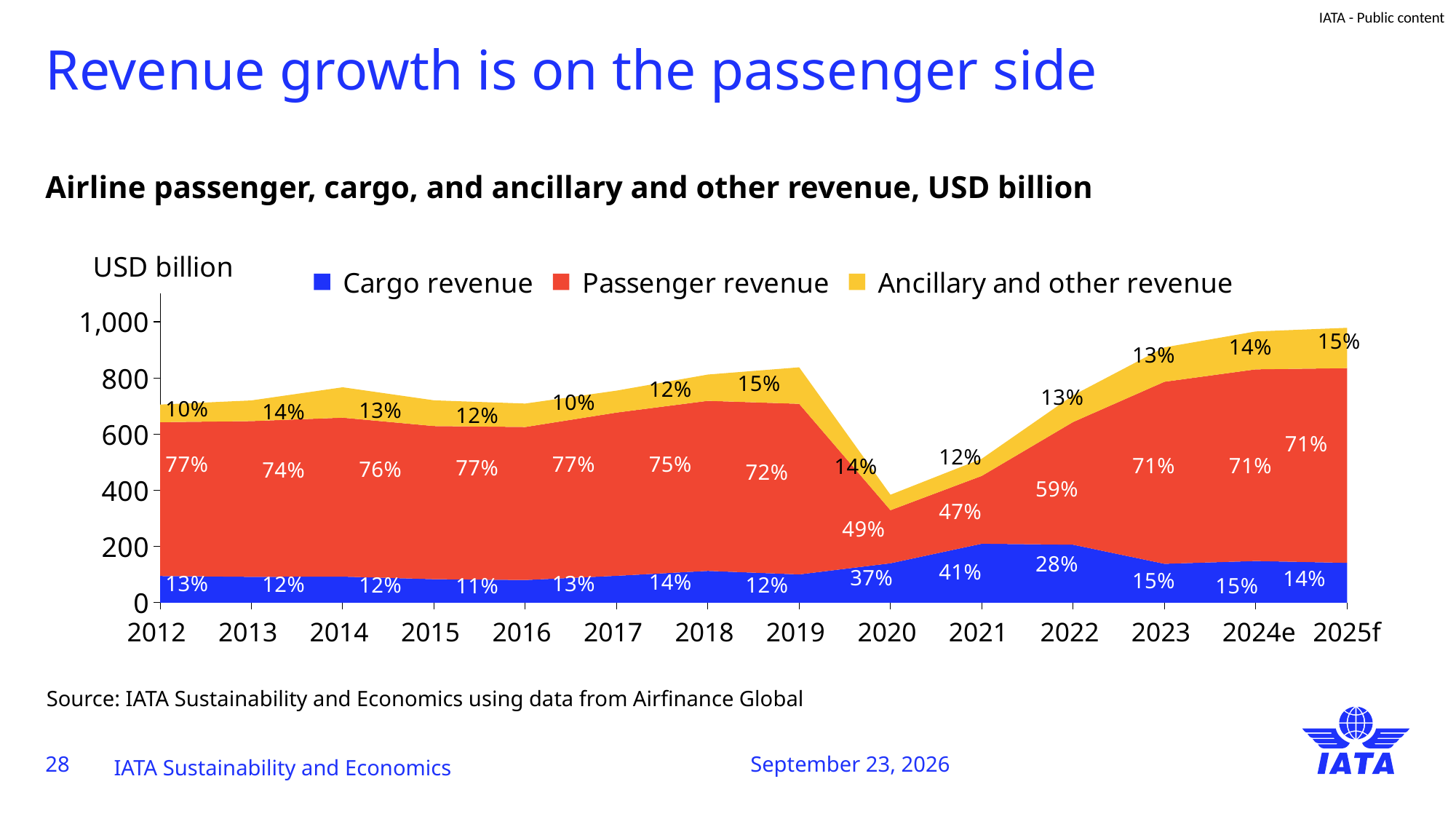
Is the total revenue in 2012 greater or less than 600 USD billion? greater Which series is shown in blue in the legend? Cargo revenue What is the chart's title? Airline passenger, cargo, and ancillary and other revenue, USD billion Is the total revenue in 2025f greater or less than 800 USD billion? greater What is the lowest passenger revenue share label shown on the chart? 47% What is the highest cargo revenue share label shown on the chart? 41% Which year has the lowest total revenue? 2020 How many series does the legend list? 3 How many years are shown along the x axis? 14 What kind of chart is shown on the slide? Stacked area chart Does total revenue rise or fall from 2020 to 2025f? Rise